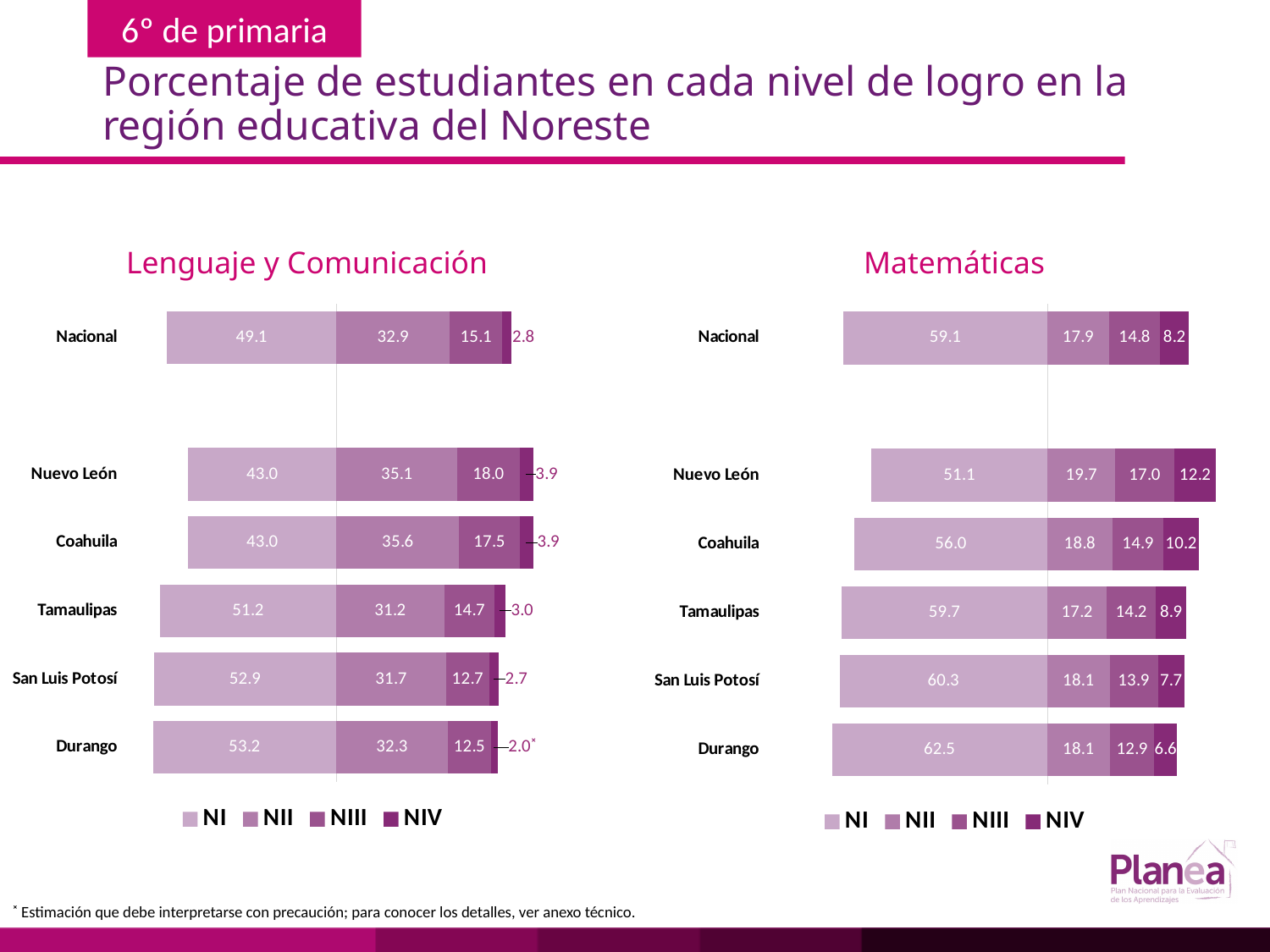
What are the legend entries of the Matemáticas chart? NI, NII, NIII, NIV In the Lenguaje y Comunicación chart, what is the NI value for Nacional? 49.1 In the Lenguaje y Comunicación chart, what is the total of the stacked bar for Coahuila? 100.0 In the Lenguaje y Comunicación chart, which category has the highest NI value? Durango What kind of chart is the Matemáticas chart? Stacked bar chart In the Matemáticas chart, which category has the lowest NIV value? Durango In the Matemáticas chart, what is the difference between the NI values for Durango and Nuevo León? 11.4 In the Matemáticas chart, what is the NII value for Coahuila? 18.8 How many series does the legend of the Lenguaje y Comunicación chart list? 4 In the Lenguaje y Comunicación chart, which is larger, the NIII value for Nuevo León or for Tamaulipas? Nuevo León In the Matemáticas chart, what is the NIV value for Nuevo León? 12.2 How many categories are shown in the Matemáticas chart? 6